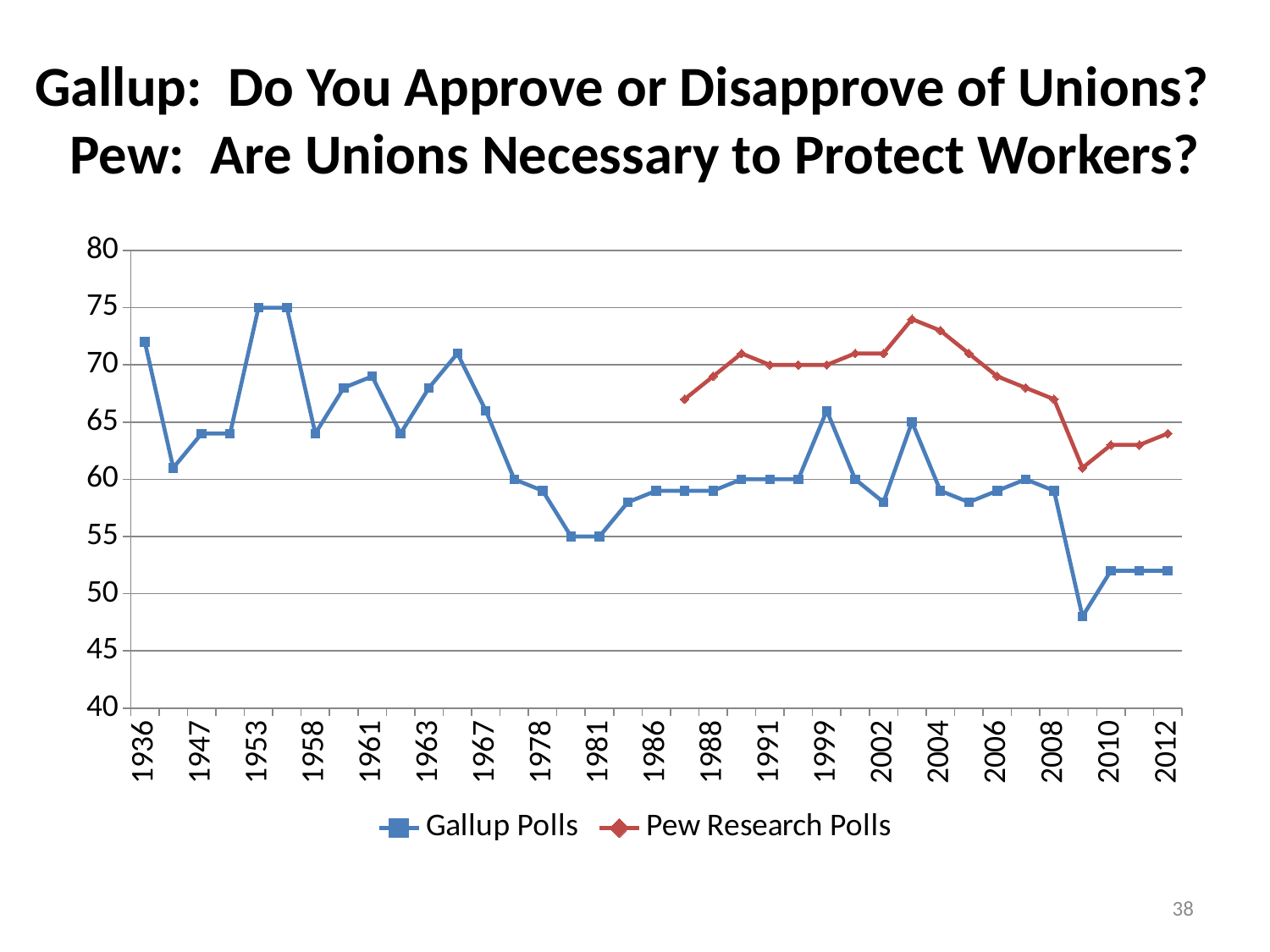
What colour is the Pew Research Polls line? red Is the Gallup Polls value for 2012 greater or less than 55? less What is the Pew Research Polls value for 1991? 70 Is the Pew Research Polls value for 2004 greater or less than 70? greater What kind of chart is shown on the slide? line chart Does the Pew Research Polls line rise or fall between 2004 and 2008? fall What is the Gallup Polls value for 1981? 55 What is the Gallup Polls value for 1991? 60 How many series does the legend list? 2 Is the Gallup Polls value for 1936 greater or less than 70? greater What is the Gallup Polls value for 1953? 75 Which series has the higher value in 2008, Gallup Polls or Pew Research Polls? Pew Research Polls